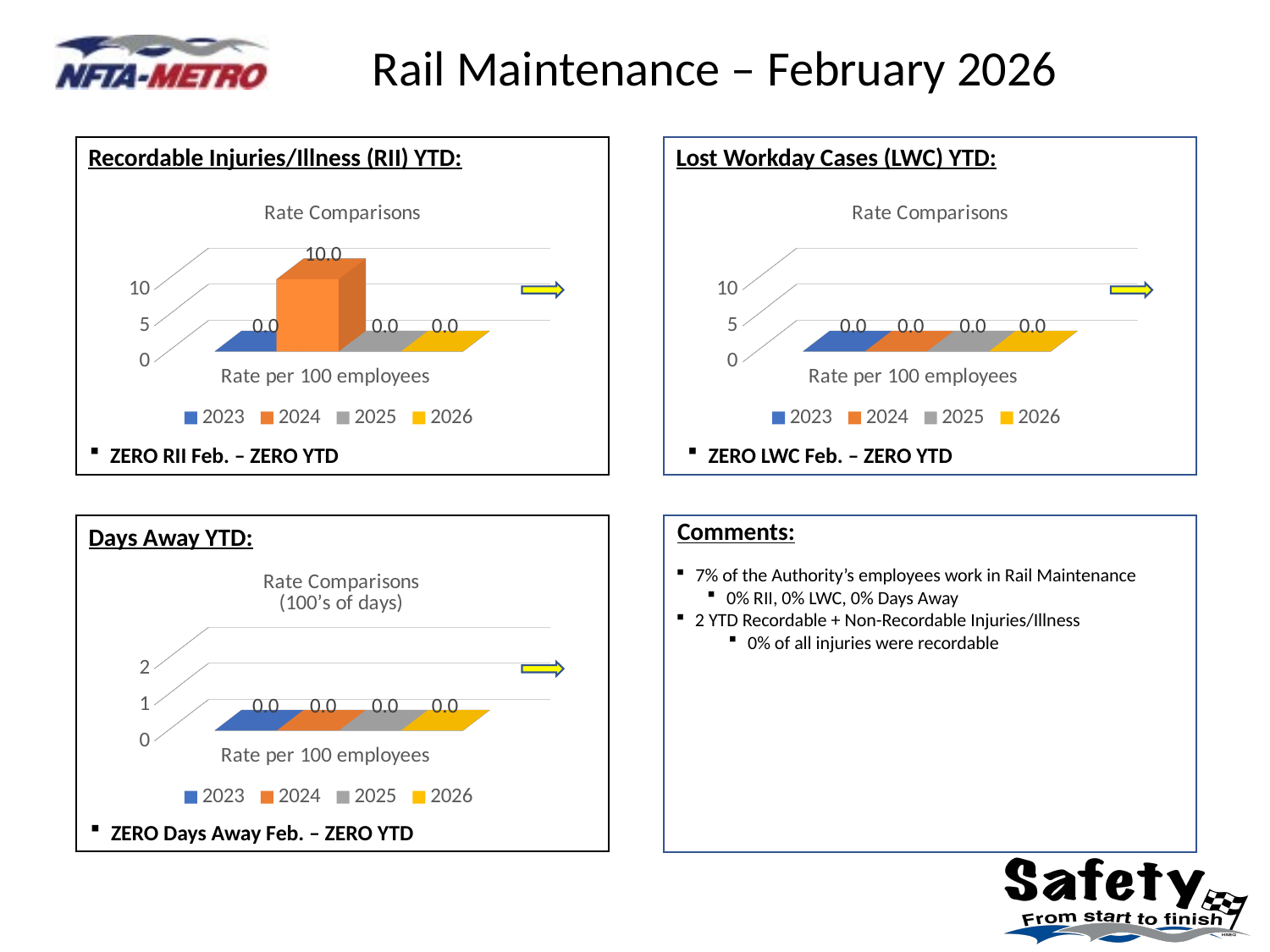
What is the title of the chart in the Days Away YTD box? Rate Comparisons (100's of days) What is the category label on the x axis of the Lost Workday Cases (LWC) YTD chart? Rate per 100 employees In the Days Away YTD chart, what is the value for 2023? 0.0 In the Recordable Injuries/Illness (RII) YTD chart, what is the value for 2026? 0.0 In the Recordable Injuries/Illness (RII) YTD chart, is the value for 2024 greater or less than 5? greater In the Recordable Injuries/Illness (RII) YTD chart, what is the difference between the 2024 value and the 2023 value? 10.0 In the Recordable Injuries/Illness (RII) YTD chart, which is larger, the value for 2024 or the value for 2025? 2024 In the Recordable Injuries/Illness (RII) YTD chart, which year has the highest value? 2024 How many series does the legend list in the Lost Workday Cases (LWC) YTD chart? 4 What kind of chart is the Days Away YTD chart? bar chart In the Lost Workday Cases (LWC) YTD chart, what is the value for 2025? 0.0 In the Recordable Injuries/Illness (RII) YTD chart, what is the value for 2024? 10.0